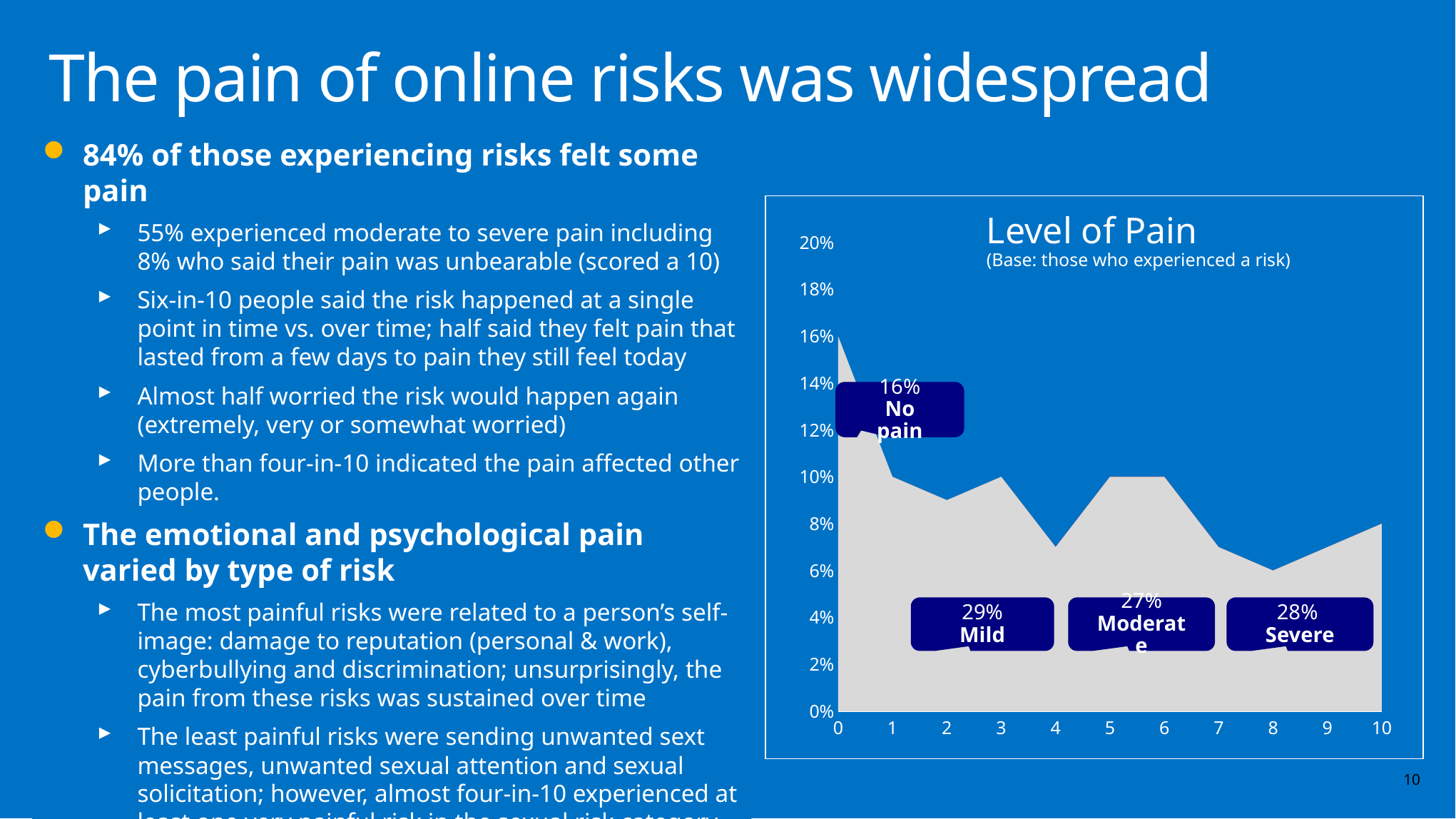
What percentage is shown for the 'Mild' pain group? 29% Which pain score on the x axis has the highest value? 0 What base is stated under the chart title? those who experienced a risk Is the value for pain score 8 greater or less than 8%? less How many pain scores are plotted along the x axis? 11 What percentage is shown for the 'Moderate' pain group? 27% What kind of chart is the Level of Pain chart? area chart What is the title of the chart on the slide? Level of Pain What percentage is shown for the 'Severe' pain group? 28% What is the difference between the Mild group (29%) and the Moderate group (27%)? 2 percentage points Is the value for pain score 0 greater or less than 14%? greater What percentage is shown for the 'No pain' group (score 0)? 16%